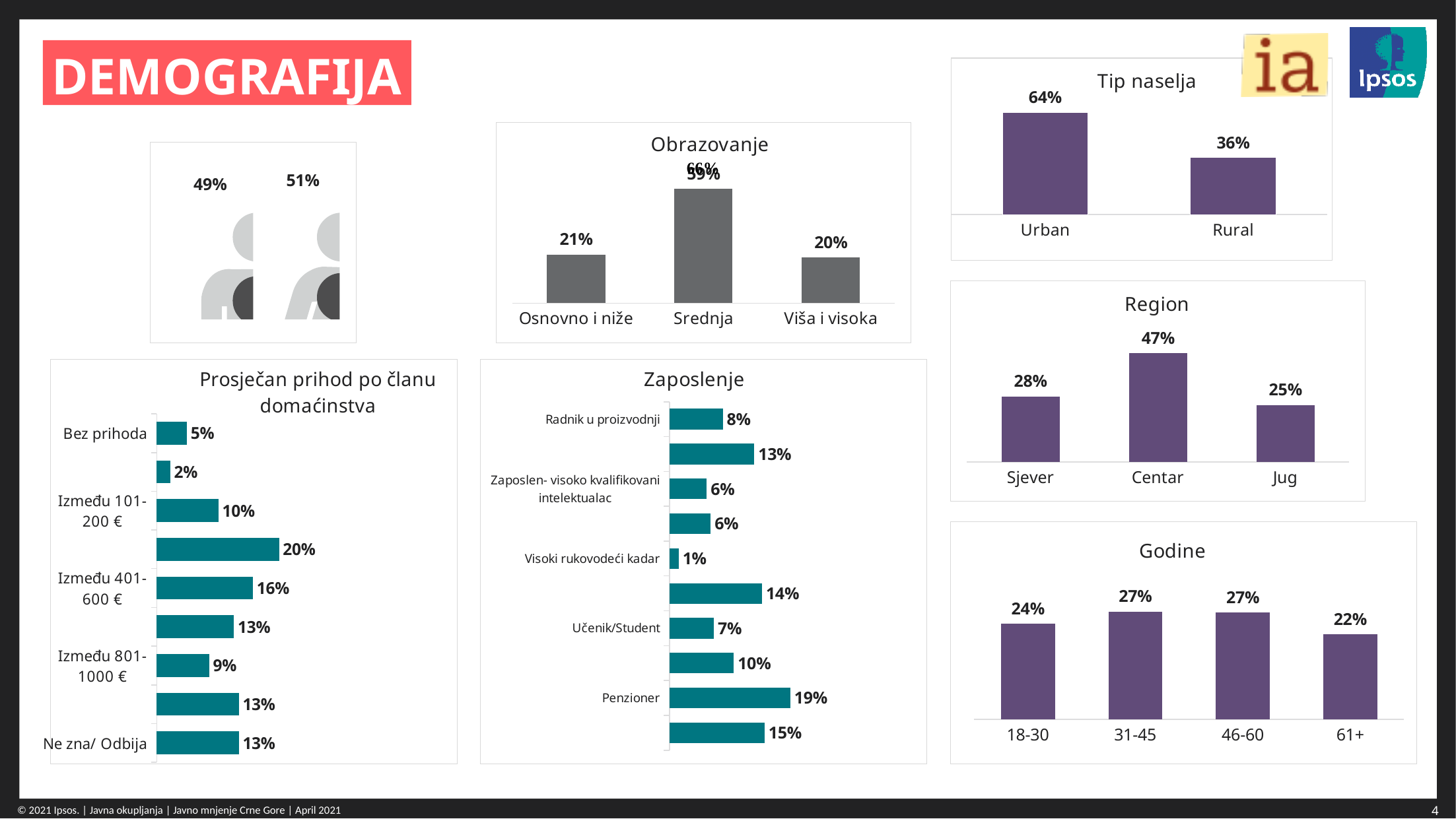
In the "Tip naselja" chart, what is the value for Urban? 64% In the "Prosječan prihod po članu domaćinstva" chart, what is the value for Između 401-600 €? 16% In the "Obrazovanje" chart, what is the value for Osnovno i niže? 21% In the "Tip naselja" chart, what is the difference between Urban and Rural? 28% In the "Godine" chart, how many age groups are shown? 4 What type of chart is the "Zaposlenje" chart? Bar chart In the "Zaposlenje" chart, which is larger: Radnik u proizvodnji or Visoki rukovodeći kadar? Radnik u proizvodnji In the "Region" chart, what is the value for Jug? 25% In the "Godine" chart, which age group has the lowest value? 61+ In the "Obrazovanje" chart, which category has the highest value? Srednja In the "Zaposlenje" chart, what is the value for Penzioner? 19% In the "Region" chart, which region has the highest value? Centar